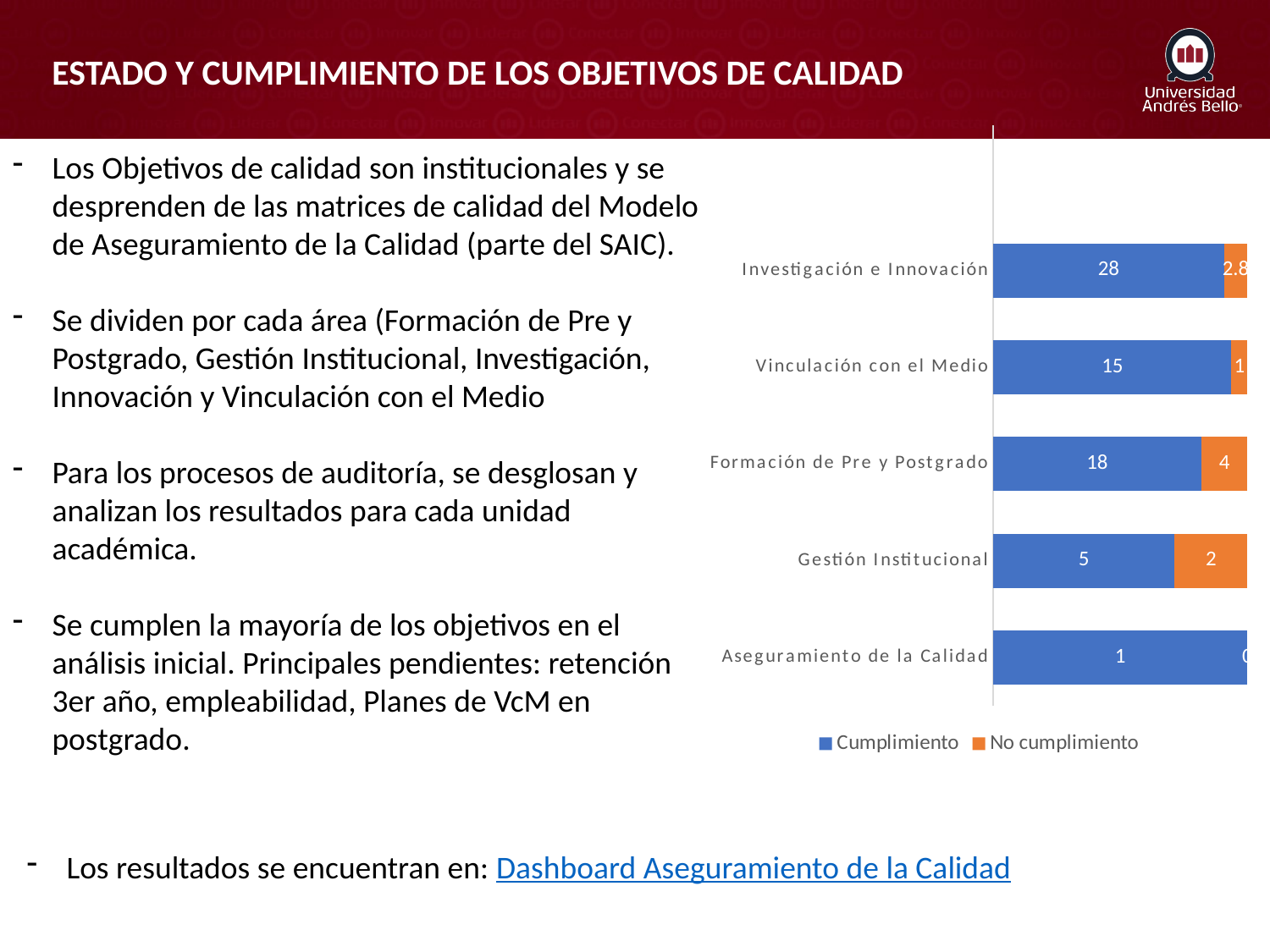
What is the total of the stacked bar for Formación de Pre y Postgrado? 22 What is the difference between the Cumplimiento values for Investigación e Innovación and Formación de Pre y Postgrado? 10 Which category has the highest Cumplimiento value? Investigación e Innovación How many series does the legend list? 2 Which category has the lowest Cumplimiento value? Aseguramiento de la Calidad What kind of chart is shown on the slide? Stacked bar chart What is the No cumplimiento value for Gestión Institucional? 2 How many categories are shown in the chart? 5 What is the Cumplimiento value for Formación de Pre y Postgrado? 18 Which has a larger Cumplimiento value, Vinculación con el Medio or Gestión Institucional? Vinculación con el Medio What is the Cumplimiento value for Investigación e Innovación? 28 What is the No cumplimiento value for Formación de Pre y Postgrado? 4